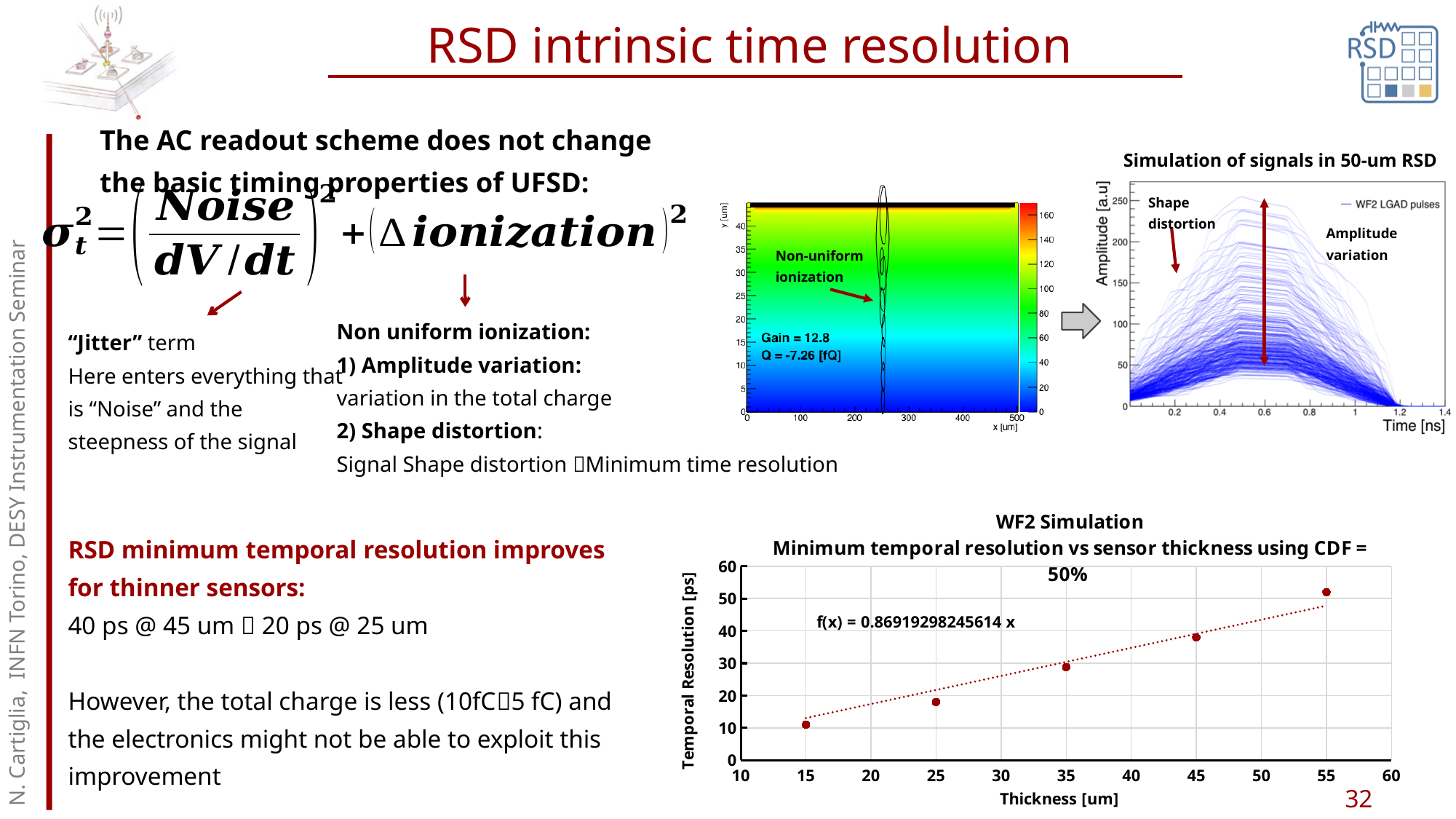
In the WF2 Simulation chart, does the temporal resolution rise or fall as thickness increases? rise In the WF2 Simulation chart, is the temporal resolution at 55 um greater or less than 50 ps? greater In the WF2 Simulation chart at the bottom right, what kind of chart is it? scatter chart In the WF2 Simulation chart, what is the label of the x axis? Thickness [um] In the WF2 Simulation chart, at which thickness is the temporal resolution highest? 55 In the WF2 Simulation chart, is the temporal resolution at 35 um greater or less than 20 ps? greater In the WF2 Simulation chart, is the temporal resolution at 15 um greater or less than 20 ps? less In the WF2 Simulation chart, at which thickness is the temporal resolution lowest? 15 In the WF2 Simulation chart, what is the trendline equation shown? f(x) = 0.86919298245614 x In the WF2 Simulation chart, which has the larger temporal resolution: 25 um or 45 um thickness? 45 um In the WF2 Simulation chart, how many data points are plotted? 5